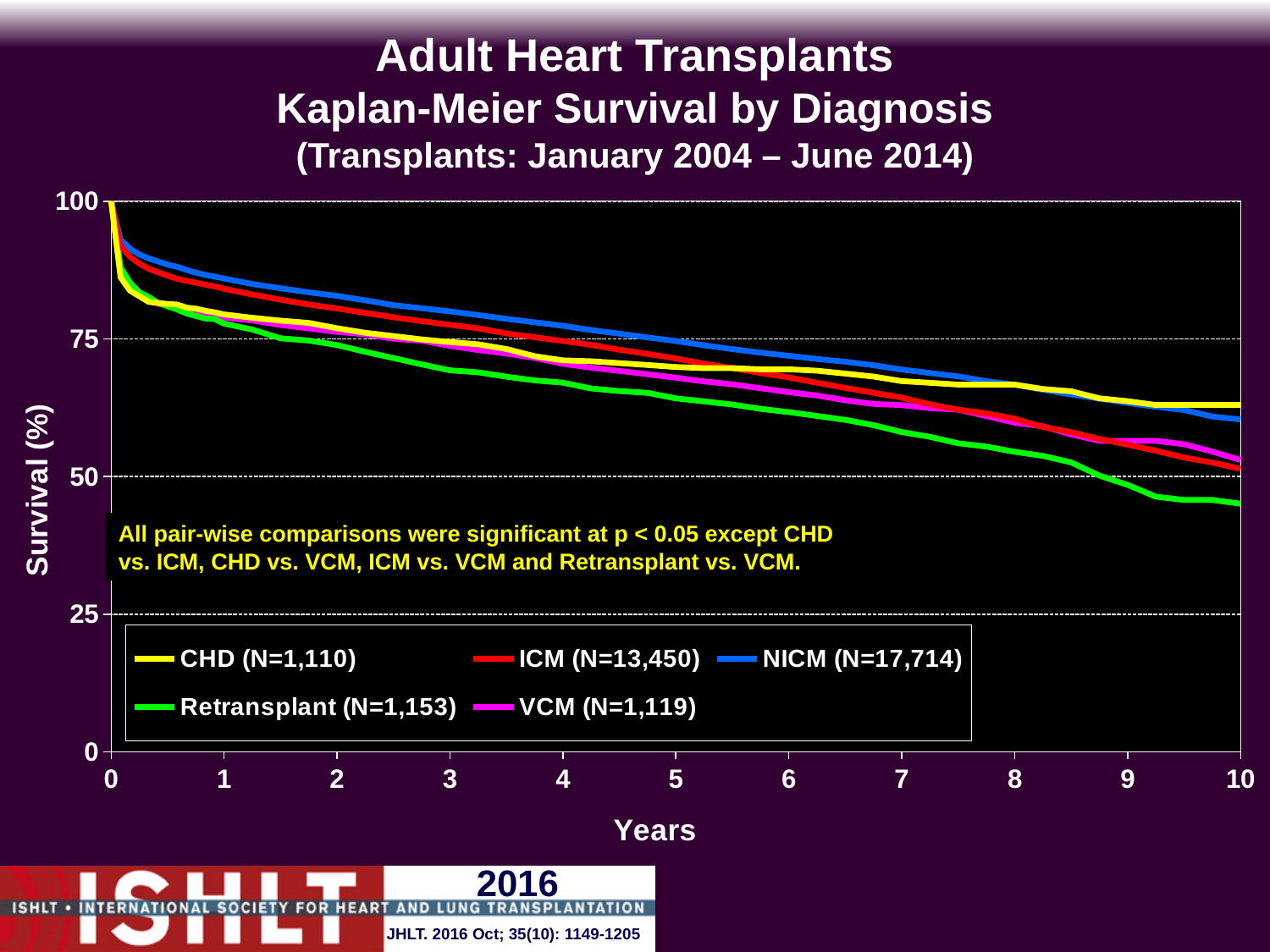
What kind of chart is shown on the slide? line chart How many series does the legend list? 5 What is the N shown in the legend for NICM? 17,714 Which diagnosis group has the highest survival at 1 year? NICM Is the survival for NICM at 1 year greater or less than 75? greater Is the survival for Retransplant at 10 years greater or less than 50? less Is the survival for Retransplant at 5 years greater or less than 75? less Which diagnosis group has the lowest survival at 10 years? Retransplant What is the label of the y axis? Survival (%) Do the survival curves rise or fall as years increase? fall At 5 years, is survival higher for NICM or for Retransplant? NICM